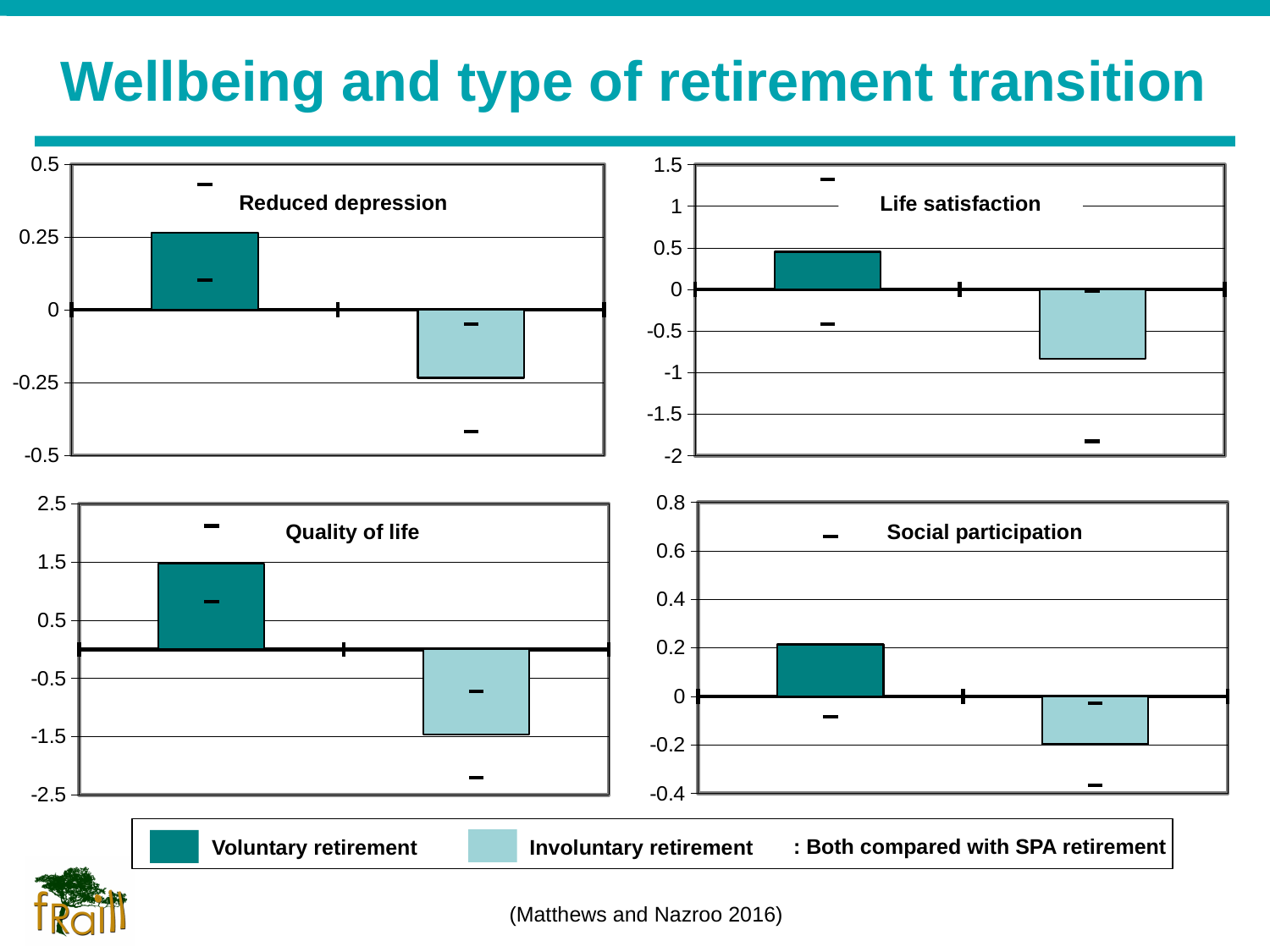
How many bars are plotted in the 'Life satisfaction' chart? 2 In the 'Quality of life' chart, is the value for Voluntary retirement greater or less than 0.5? greater What kind of chart is the 'Reduced depression' chart? bar chart How many series does the legend at the bottom of the slide list? 2 What is the title of the chart in the top-right position on the slide? Life satisfaction Which series is shown in the lighter colour in the legend? Involuntary retirement In the 'Life satisfaction' chart, is the value for Involuntary retirement greater or less than -0.5? less In the 'Social participation' chart, which bar is lowest? Involuntary retirement In the 'Quality of life' chart, is the value for Involuntary retirement greater or less than -0.5? less In the 'Reduced depression' chart, which is larger, the value for Voluntary retirement or Involuntary retirement? Voluntary retirement